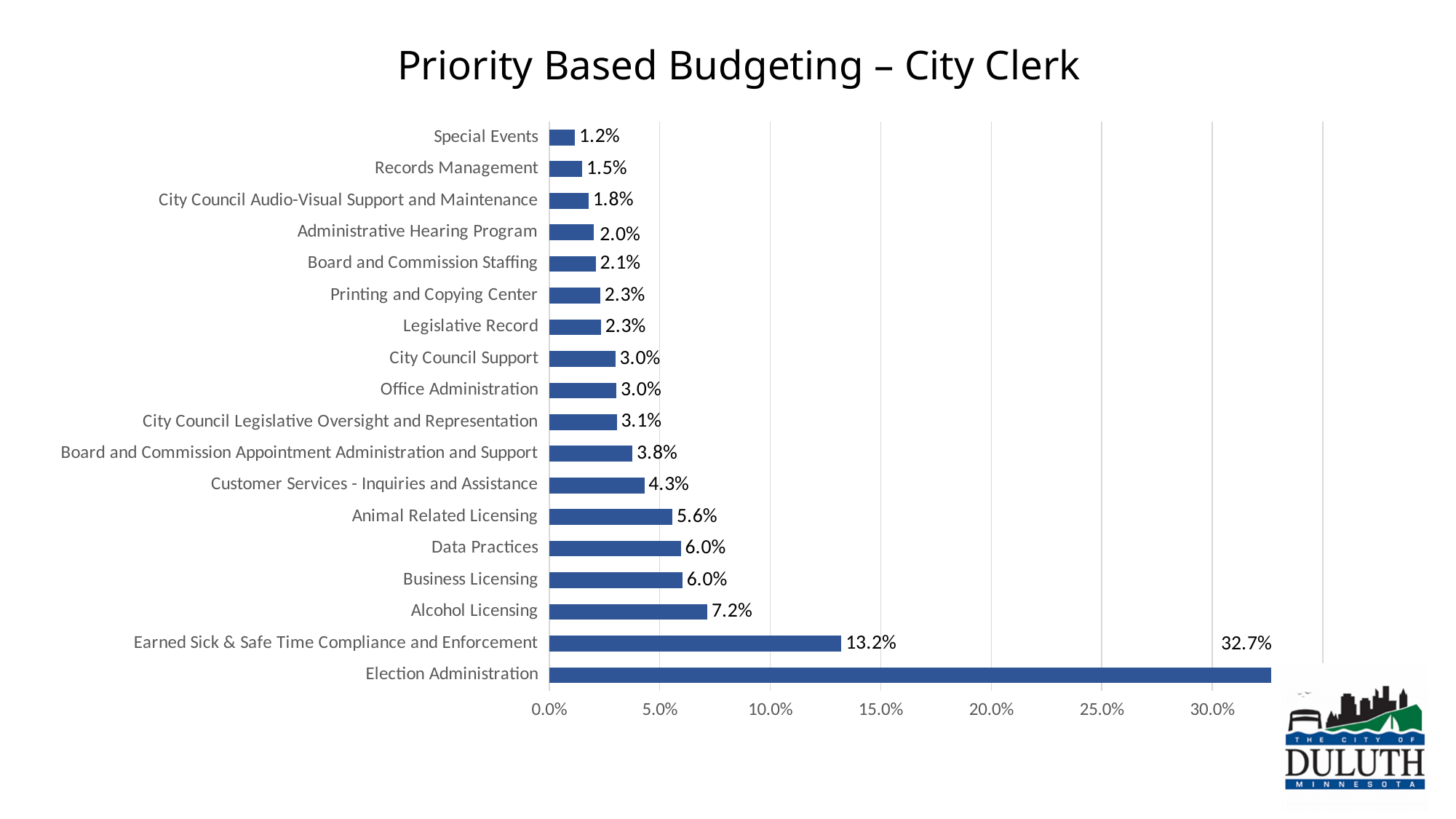
What is the value for Election Administration? 32.7% What is the value for Customer Services - Inquiries and Assistance? 4.3% What is the difference between Election Administration and Earned Sick & Safe Time Compliance and Enforcement? 19.5% What is the value for Alcohol Licensing? 7.2% Which category has the highest value? Election Administration How many categories are shown in the chart? 18 Is the value for Earned Sick & Safe Time Compliance and Enforcement greater or less than 10.0%? greater What is the value for Earned Sick & Safe Time Compliance and Enforcement? 13.2% What kind of chart is shown on the slide? bar chart Which category has the lowest value? Special Events Which is larger, Animal Related Licensing or Alcohol Licensing? Alcohol Licensing What is the title of the slide? Priority Based Budgeting – City Clerk